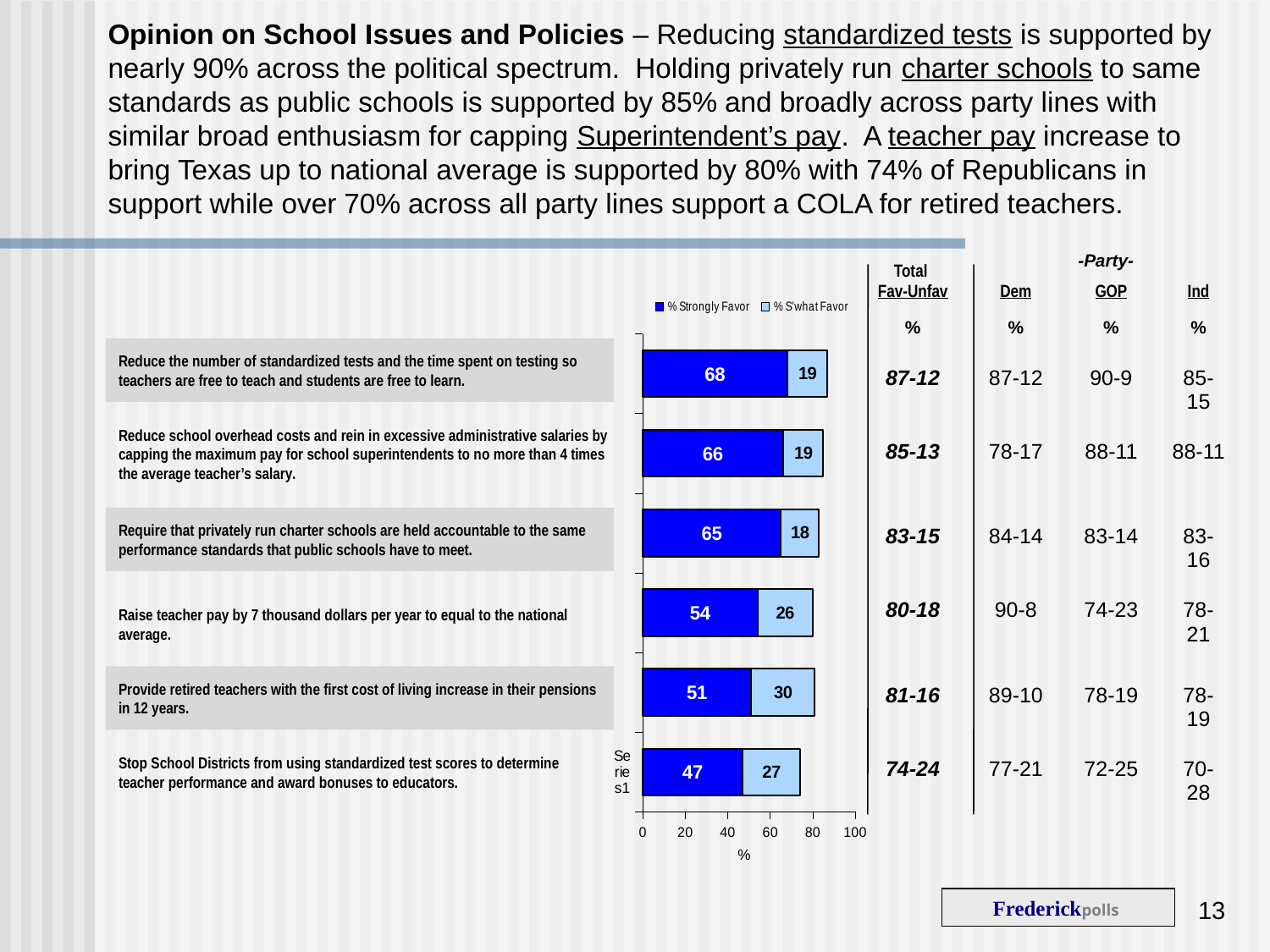
How many statements (bars) are shown in the chart? 6 What is the % Strongly Favor value for "Reduce the number of standardized tests and the time spent on testing"? 68 Which has a larger % Strongly Favor value: raising teacher pay by 7 thousand dollars or providing retired teachers a cost of living increase? Raising teacher pay by 7 thousand dollars How many series does the chart legend list? 2 What is the total of the stacked bar for "Require that privately run charter schools are held accountable to the same performance standards"? 83 What kind of chart is shown on the slide? Stacked bar chart Which statement has the highest % S'what Favor value? Provide retired teachers with the first cost of living increase in their pensions What is the % Strongly Favor value for "Raise teacher pay by 7 thousand dollars per year to equal to the national average"? 54 Which statement has the highest % Strongly Favor value? Reduce the number of standardized tests and the time spent on testing Which statement has the lowest % Strongly Favor value? Stop School Districts from using standardized test scores to determine teacher performance What is the difference between the % Strongly Favor for reducing standardized tests (68) and for stopping districts from using test scores for teacher bonuses (47)? 21 What is the % S'what Favor value for "Provide retired teachers with the first cost of living increase in their pensions in 12 years"? 30